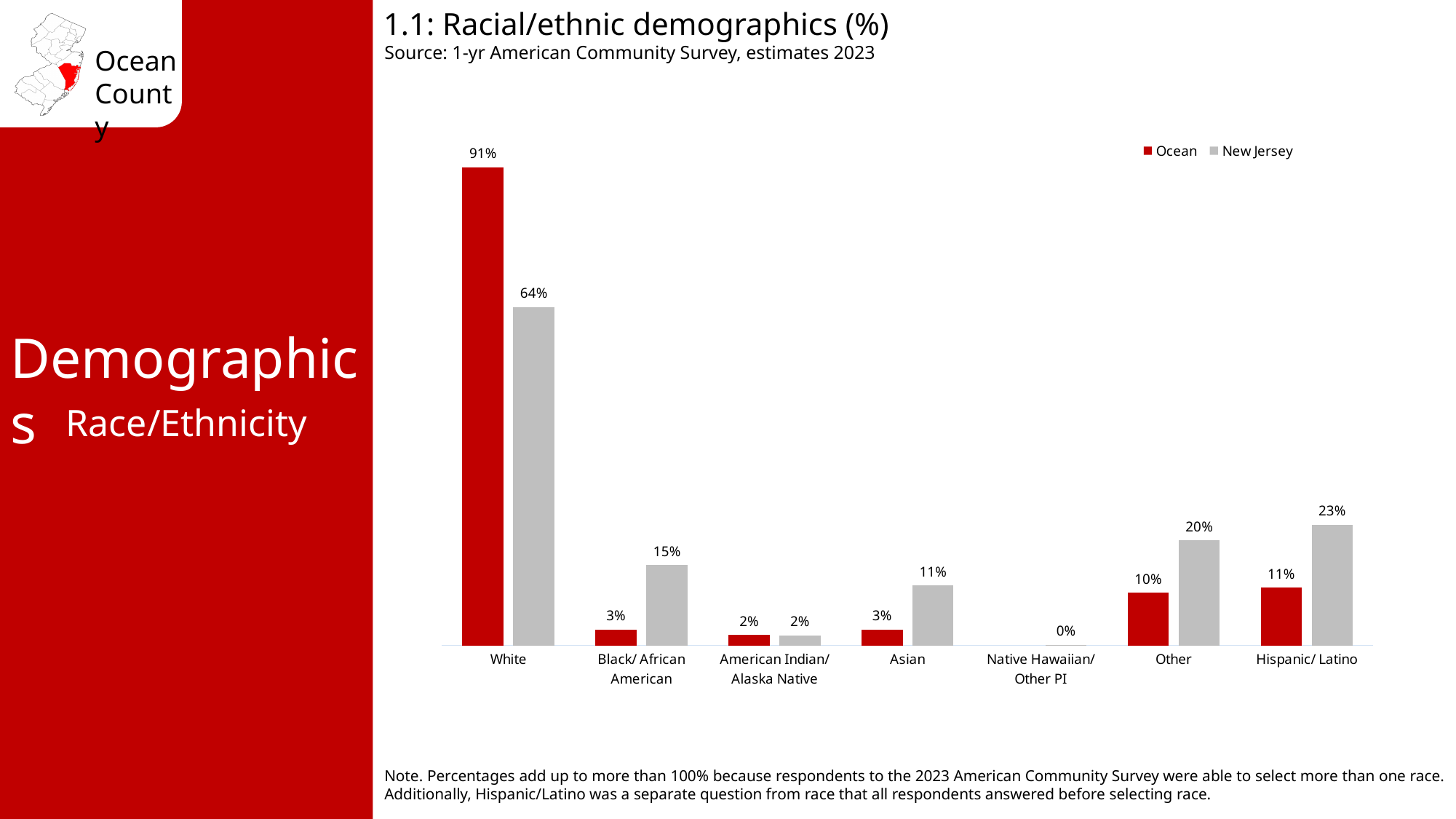
What is the New Jersey value for Hispanic/ Latino? 23% Which category has the highest Ocean value? White How many categories are shown on the x axis? 7 What is the difference between the New Jersey and Ocean values for Asian? 8% What is the Ocean value for Other? 10% Which category has the highest New Jersey value? White What is the New Jersey value for Black/ African American? 15% What kind of chart is shown on the slide? Bar chart Which is larger for Hispanic/ Latino, the Ocean value or the New Jersey value? New Jersey What is the Ocean value for White? 91% What is the difference between the Ocean and New Jersey values for White? 27% How many series does the legend list? 2